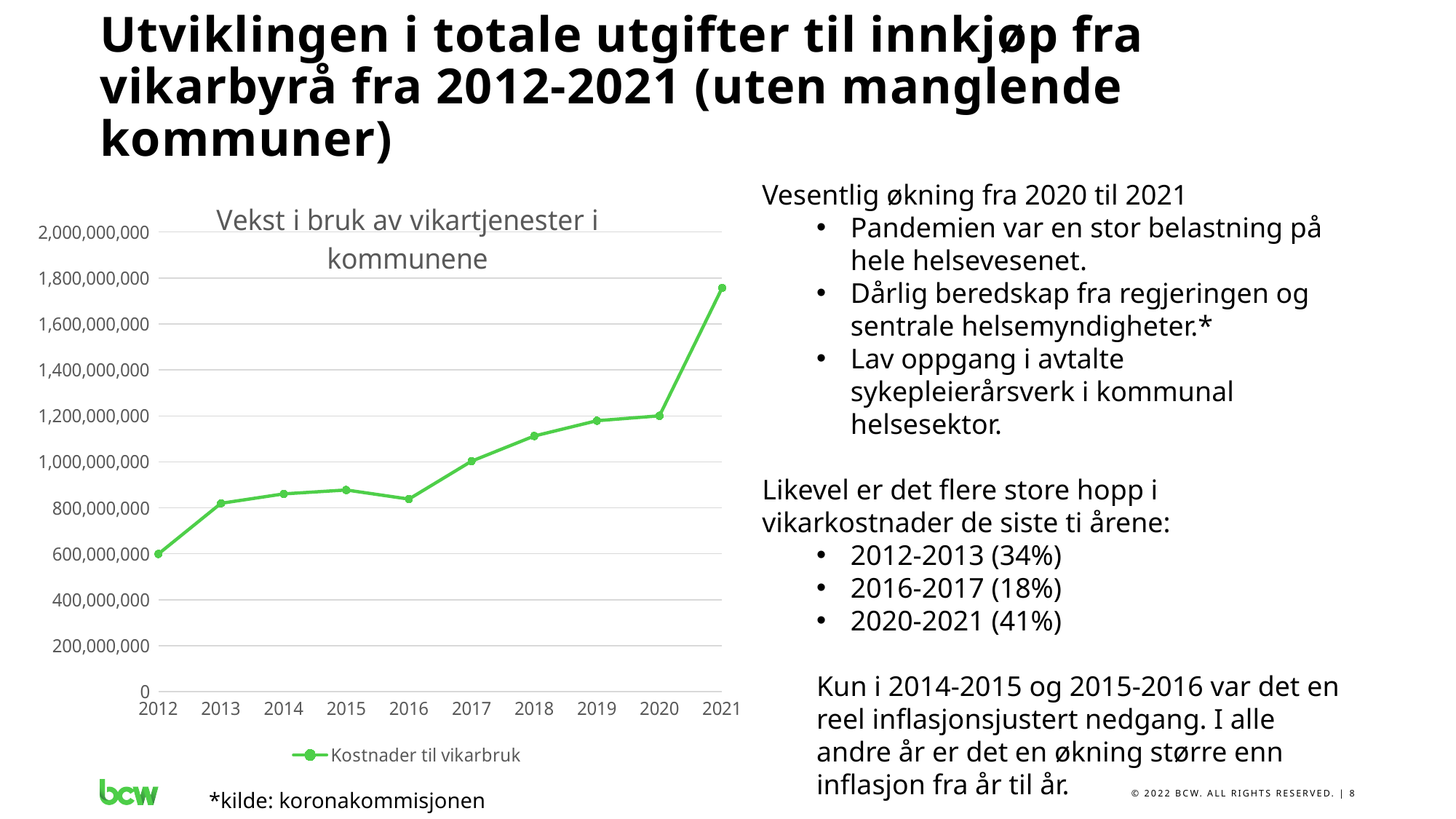
How many series does the chart legend list? 1 What kind of chart is shown on the slide? Line chart Is the value for 2012 greater or less than 800,000,000? less Which year has the lowest value for Kostnader til vikarbruk? 2012 Do the values for Kostnader til vikarbruk generally rise or fall from 2012 to 2021? Rise Is the value for 2016 greater or less than 1,000,000,000? less Is the value for 2017 greater or less than 800,000,000? greater Which year has the highest value for Kostnader til vikarbruk? 2021 How many years (data points) are plotted on the x axis of the chart? 10 Which year has the larger value, 2015 or 2016? 2015 What is the title of the chart? Vekst i bruk av vikartjenester i kommunene